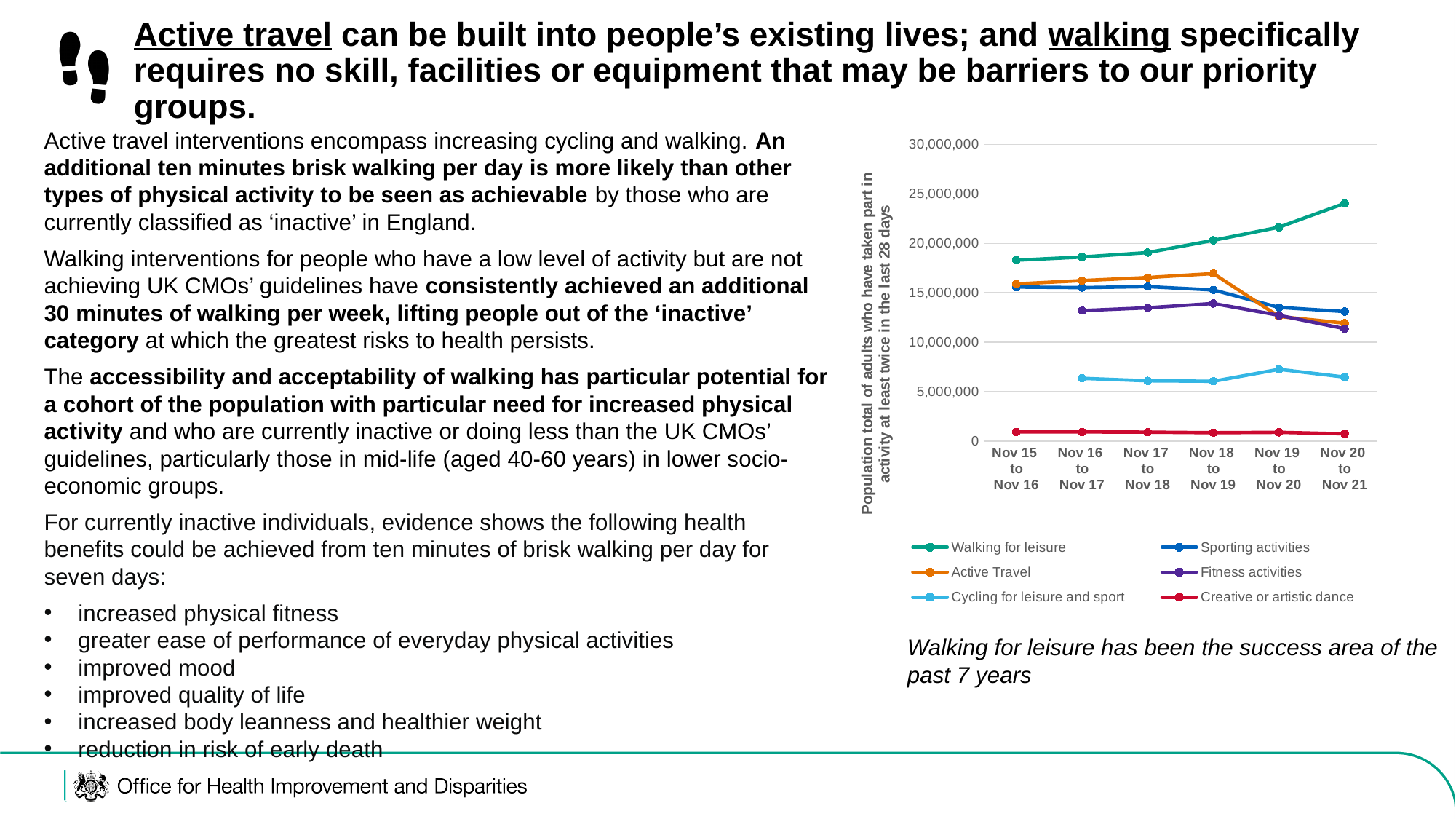
What kind of chart is shown on the slide? Line chart Is the value for Walking for leisure in Nov 20 to Nov 21 greater or less than 20,000,000? greater Which series has the lowest values across all periods in the chart? Creative or artistic dance Is the value for Creative or artistic dance in Nov 15 to Nov 16 greater or less than 5,000,000? less Which series has the highest value in the Nov 20 to Nov 21 period? Walking for leisure Does the value for Walking for leisure rise or fall from Nov 15 to Nov 16 through Nov 20 to Nov 21? Rise In the Nov 16 to Nov 17 period, which is larger: Sporting activities or Fitness activities? Sporting activities What is the label on the chart's vertical axis? Population total of adults who have taken part in activity at least twice in the last 28 days Is the value for Active Travel in Nov 18 to Nov 19 greater or less than 15,000,000? greater How many series does the chart's legend list? 6 How many time periods are shown along the x axis of the chart? 6